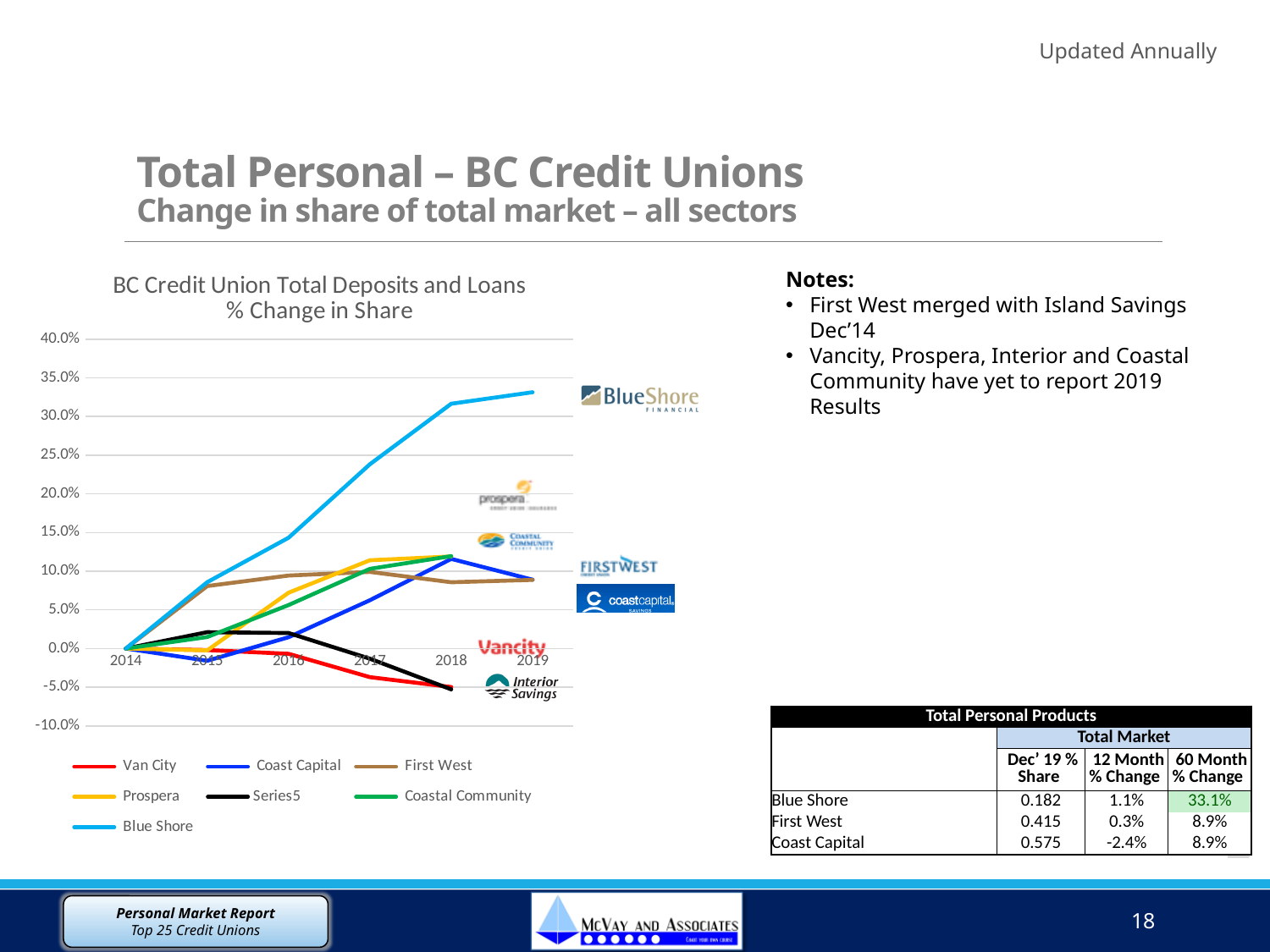
Does the Blue Shore line rise or fall from 2014 to 2019? rise Does the Van City line rise or fall from 2016 to 2018? fall What kind of chart is shown on the slide? line chart How many years are shown along the x axis of the chart? 6 Is the value for Blue Shore in 2016 greater or less than 10.0%? greater Which series has the highest value in 2019? Blue Shore Which is larger in 2019, the value for Blue Shore or the value for Coast Capital? Blue Shore What is the title of the chart? BC Credit Union Total Deposits and Loans % Change in Share How many series does the chart legend list? 7 Is the value for Coast Capital in 2018 greater or less than 10.0%? greater Is the value for Van City in 2018 greater or less than 0.0%? less